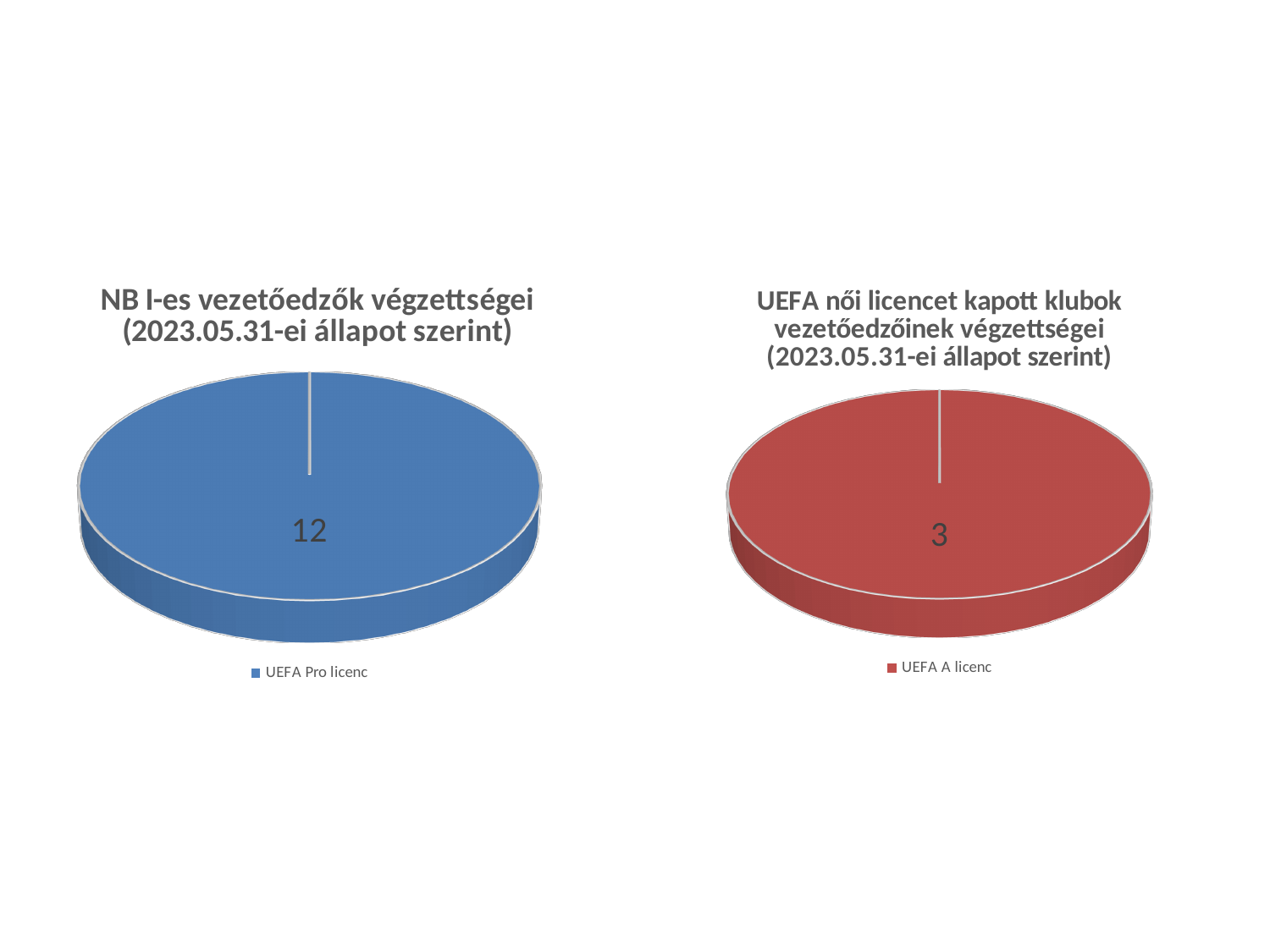
In the left chart (NB I-es vezetőedzők végzettségei), what value is shown for UEFA Pro licenc? 12 How many slices does the right chart (UEFA női licencet kapott klubok vezetőedzőinek végzettségei) have? 1 How many entries does the legend of the right chart list? 1 In the right chart (UEFA női licencet kapott klubok vezetőedzőinek végzettségei), what value is shown for UEFA A licenc? 3 What share of the right chart's pie does the UEFA A licenc slice represent? 100% What kind of chart is the right chart on the slide? Pie chart How many slices does the left chart (NB I-es vezetőedzők végzettségei) have? 1 How many entries does the legend of the left chart list? 1 What kind of chart is the left chart on the slide? Pie chart What is the legend entry of the right chart (UEFA női licencet kapott klubok vezetőedzőinek végzettségei)? UEFA A licenc What colour is the pie in the left chart (NB I-es vezetőedzők végzettségei)? Blue What share of the left chart's pie does the UEFA Pro licenc slice represent? 100%